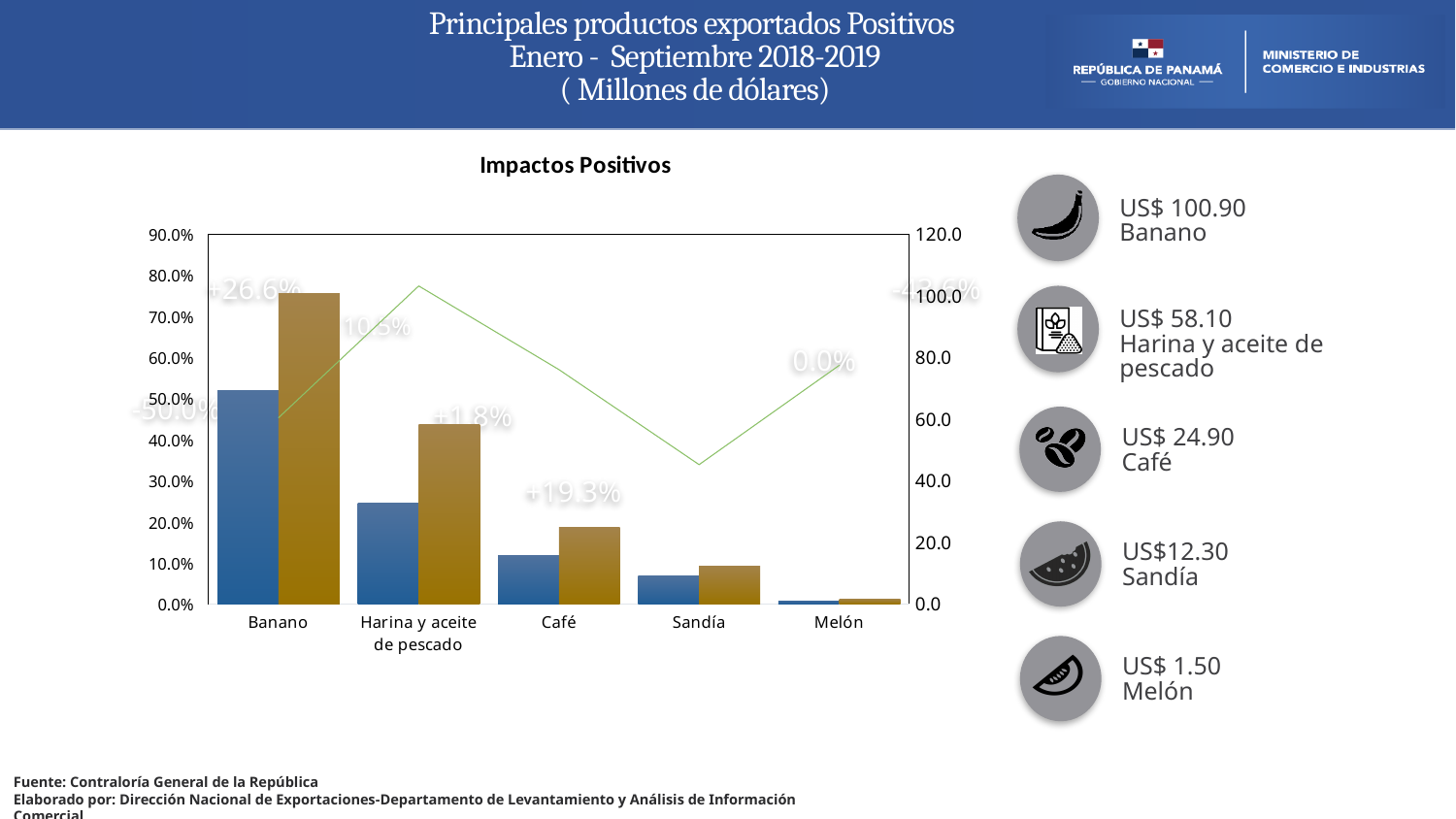
How many product categories are shown on the x axis of the chart? 5 What is the highest tick value shown on the right-hand axis of the chart? 120.0 Is the gold bar for Banano greater or less than 70.0% on the left axis? greater Which has a taller gold bar, Banano or Harina y aceite de pescado? Banano Is the blue bar for Café greater or less than 20.0% on the left axis? less Which category has the tallest bars in the chart? Banano Which category has the shortest bars in the chart? Melón Do the bar heights rise or fall moving from Banano to Melón along the x axis? fall What kind of chart is shown under the title 'Impactos Positivos'? A bar chart combined with a line Is the gold bar for Harina y aceite de pescado greater or less than 50.0% on the left axis? less What is the title shown above the chart? Impactos Positivos